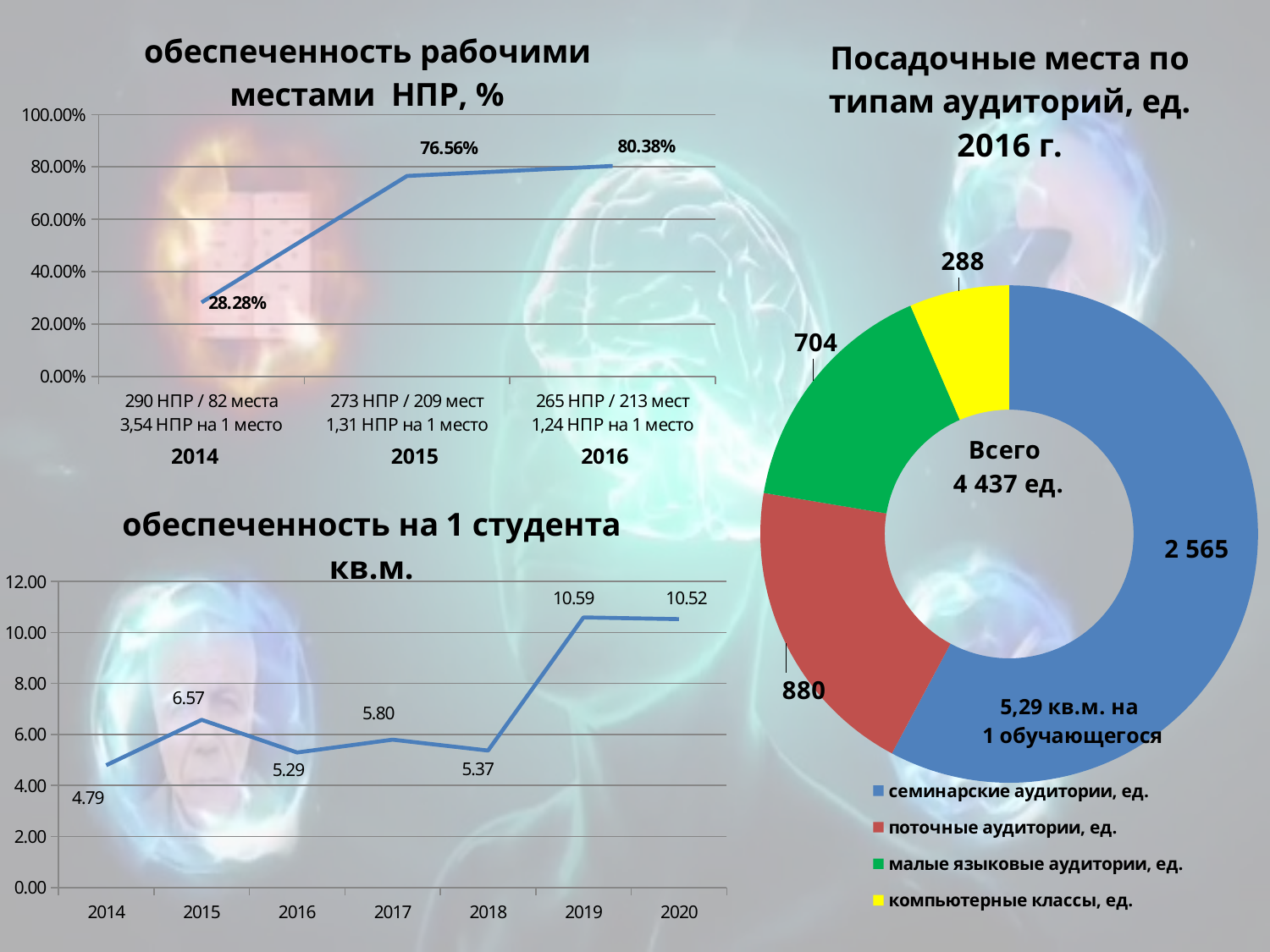
In the chart 'Посадочные места по типам аудиторий, ед. 2016 г.', what is the value for поточные аудитории? 880 In the chart 'обеспеченность рабочими местами НПР, %', do the values rise or fall from 2014 to 2016? rise In the chart 'обеспеченность на 1 студента кв.м.', how many years are plotted on the x axis? 7 In the chart 'обеспеченность на 1 студента кв.м.', is the value for 2015 larger or smaller than the value for 2018? larger In the chart 'обеспеченность рабочими местами НПР, %', what is the value for 2015? 76.56% In the chart 'обеспеченность на 1 студента кв.м.', which year has the highest value? 2019 In the chart 'обеспеченность на 1 студента кв.м.', what is the value for 2017? 5.80 What kind of chart is 'обеспеченность на 1 студента кв.м.'? line chart In the chart 'Посадочные места по типам аудиторий, ед. 2016 г.', which category has the smallest value? компьютерные классы, ед. In the chart 'обеспеченность рабочими местами НПР, %', which year has the lowest value? 2014 How many entries does the legend of the chart 'Посадочные места по типам аудиторий, ед. 2016 г.' list? 4 In the chart 'обеспеченность рабочими местами НПР, %', what is the difference between the 2016 and 2014 values? 52.10%